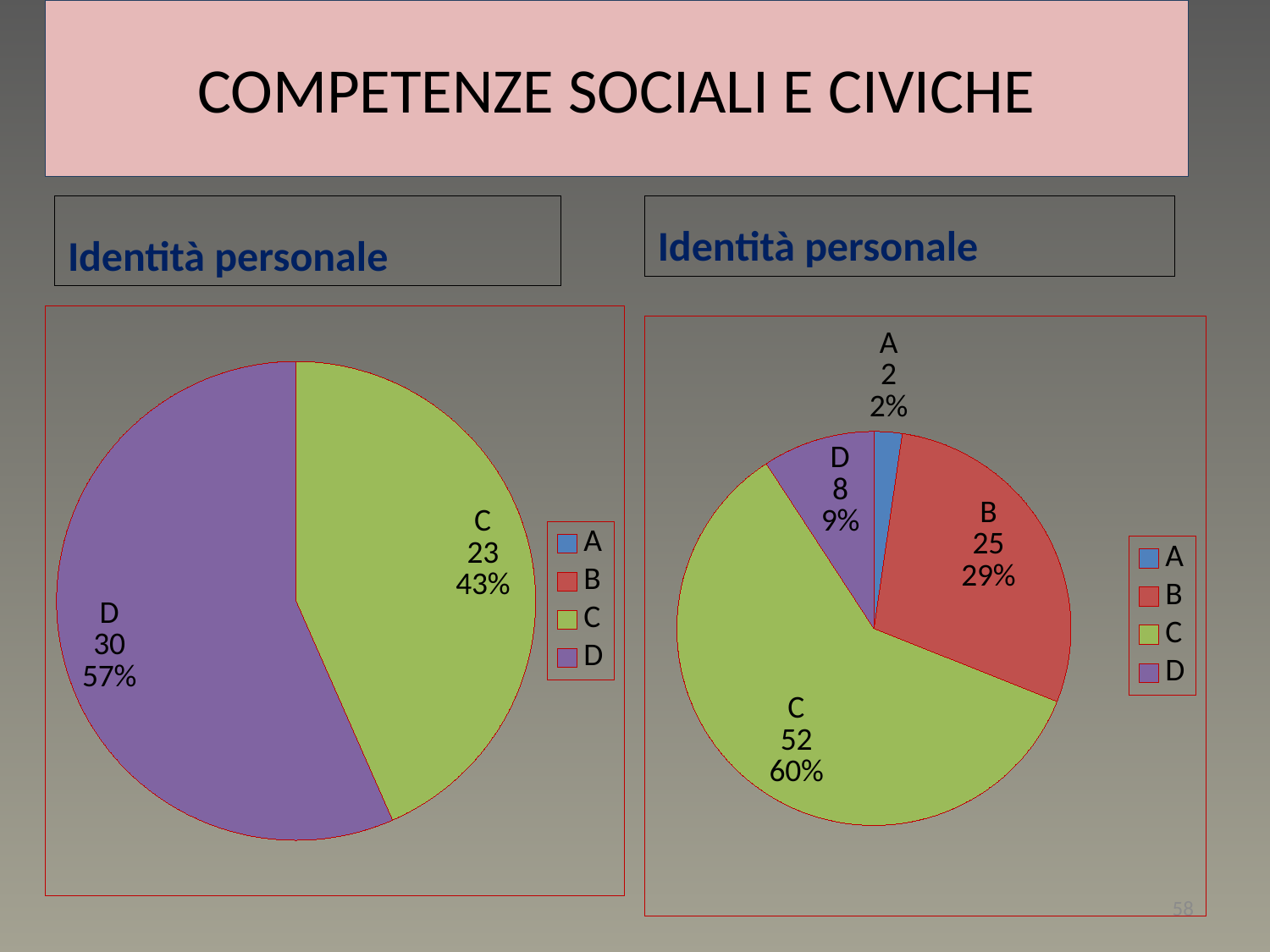
In the left pie chart, what share of the pie does category C represent? 43% In the right pie chart, what is the value for category B? 25 In the right pie chart, what share of the pie does category C represent? 60% In the left pie chart, what is the difference between the values for D and C? 7 In the right pie chart, which category has the largest slice? C How many entries does the legend of the right pie chart list? 4 In the right pie chart, what is the difference between the values for C and B? 27 In the left pie chart, what is the value for category D? 30 In the right pie chart, which is larger, the value for B or the value for D? B In the left pie chart, which category has the largest slice? D In the right pie chart, which category has the smallest slice? A What kind of chart is the left chart on the slide? Pie chart